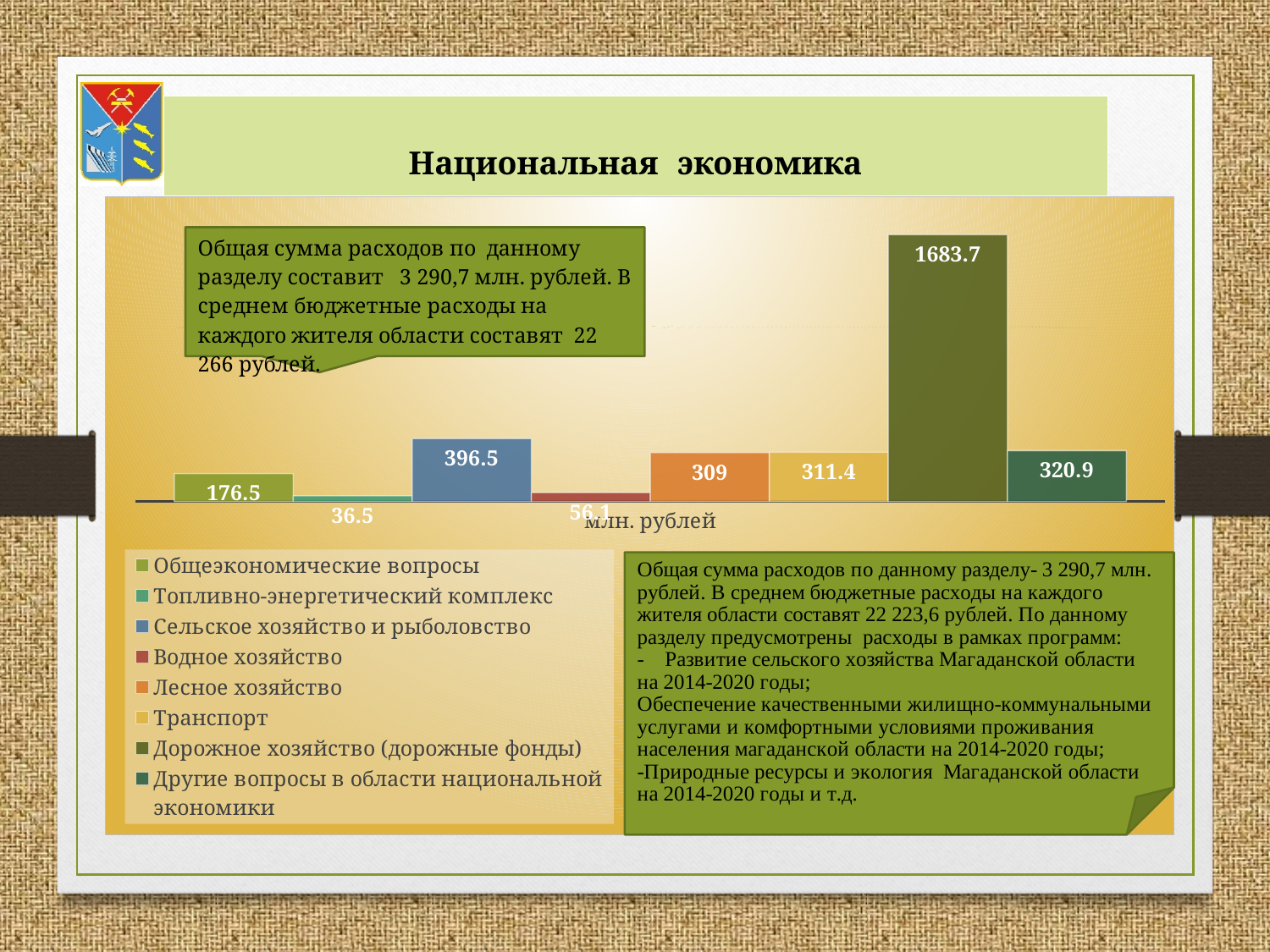
What kind of chart is shown on the slide? Bar chart What is the value for Общеэкономические вопросы in the chart? 176.5 Which is larger: the value for Сельское хозяйство и рыболовство or the value for Другие вопросы в области национальной экономики? Сельское хозяйство и рыболовство Which category has the lowest value in the chart? Топливно-энергетический комплекс What is the value for Транспорт in the chart? 311.4 What is the value for Дорожное хозяйство (дорожные фонды) in the chart? 1683.7 What is the difference between the values for Дорожное хозяйство (дорожные фонды) and Другие вопросы в области национальной экономики? 1362.8 What is the difference between the values for Сельское хозяйство и рыболовство and Общеэкономические вопросы? 220 How many entries does the chart legend list? 8 What is the value for Сельское хозяйство и рыболовство in the chart? 396.5 Which category has the highest value in the chart? Дорожное хозяйство (дорожные фонды) What is the value for Лесное хозяйство in the chart? 309